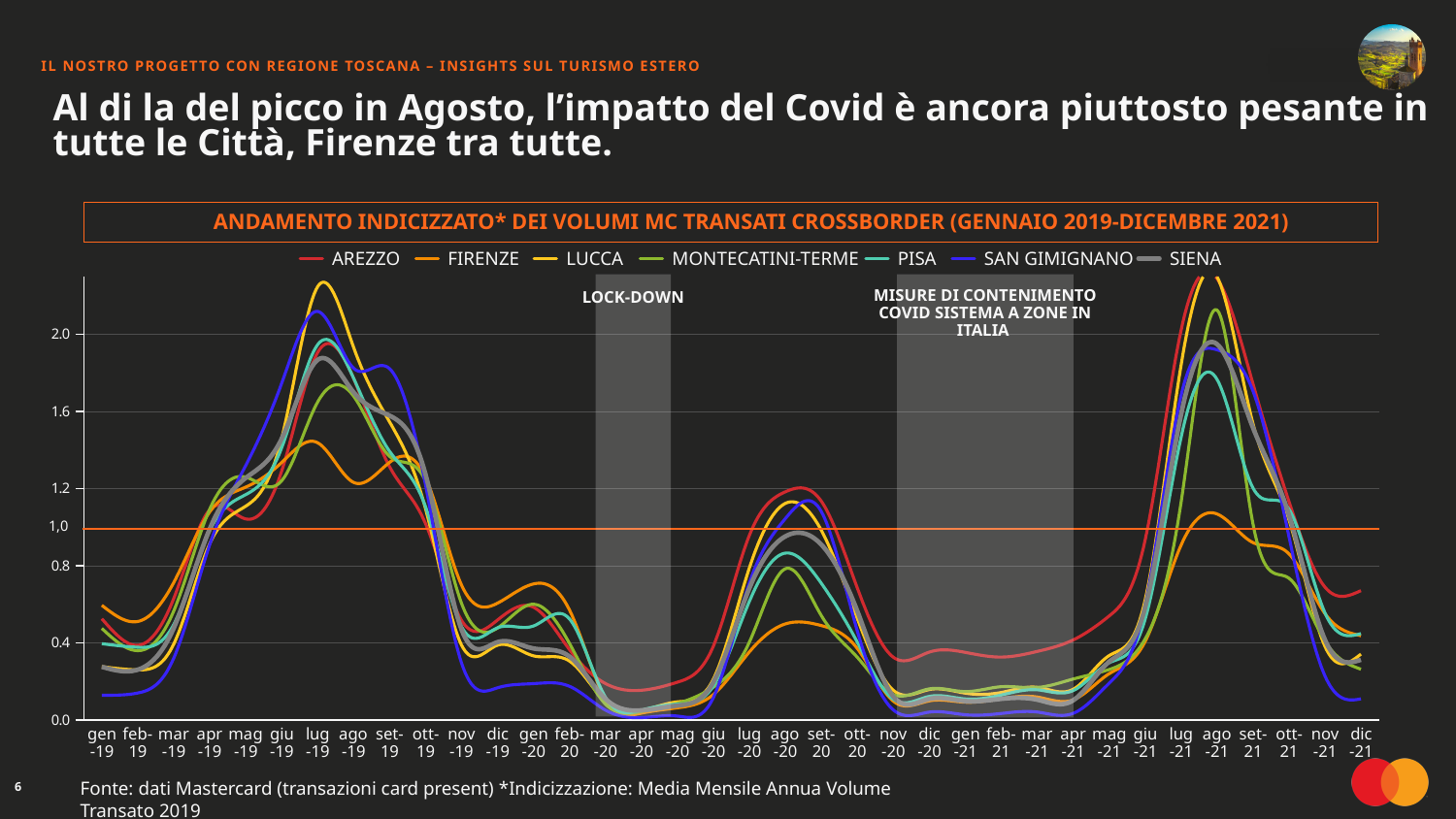
In ago-21, which is larger, the value for FIRENZE or the value for LUCCA? LUCCA How many series does the legend list? 7 Which series has the lowest value in ago-21? FIRENZE How many monthly points are plotted along the x axis? 36 Is the value for SAN GIMIGNANO in apr-20 greater or less than 0.4? less Which series has the lowest value in ago-20? FIRENZE What kind of chart is shown on the slide? line chart Is the value for LUCCA in lug-19 greater or less than 2.0? greater Which series has the highest value in lug-19? LUCCA Which series has the highest value in feb-21? AREZZO What is the title of the chart? ANDAMENTO INDICIZZATO* DEI VOLUMI MC TRANSATI CROSSBORDER (GENNAIO 2019-DICEMBRE 2021) Is the value for FIRENZE in ago-20 greater or less than 0.8? less